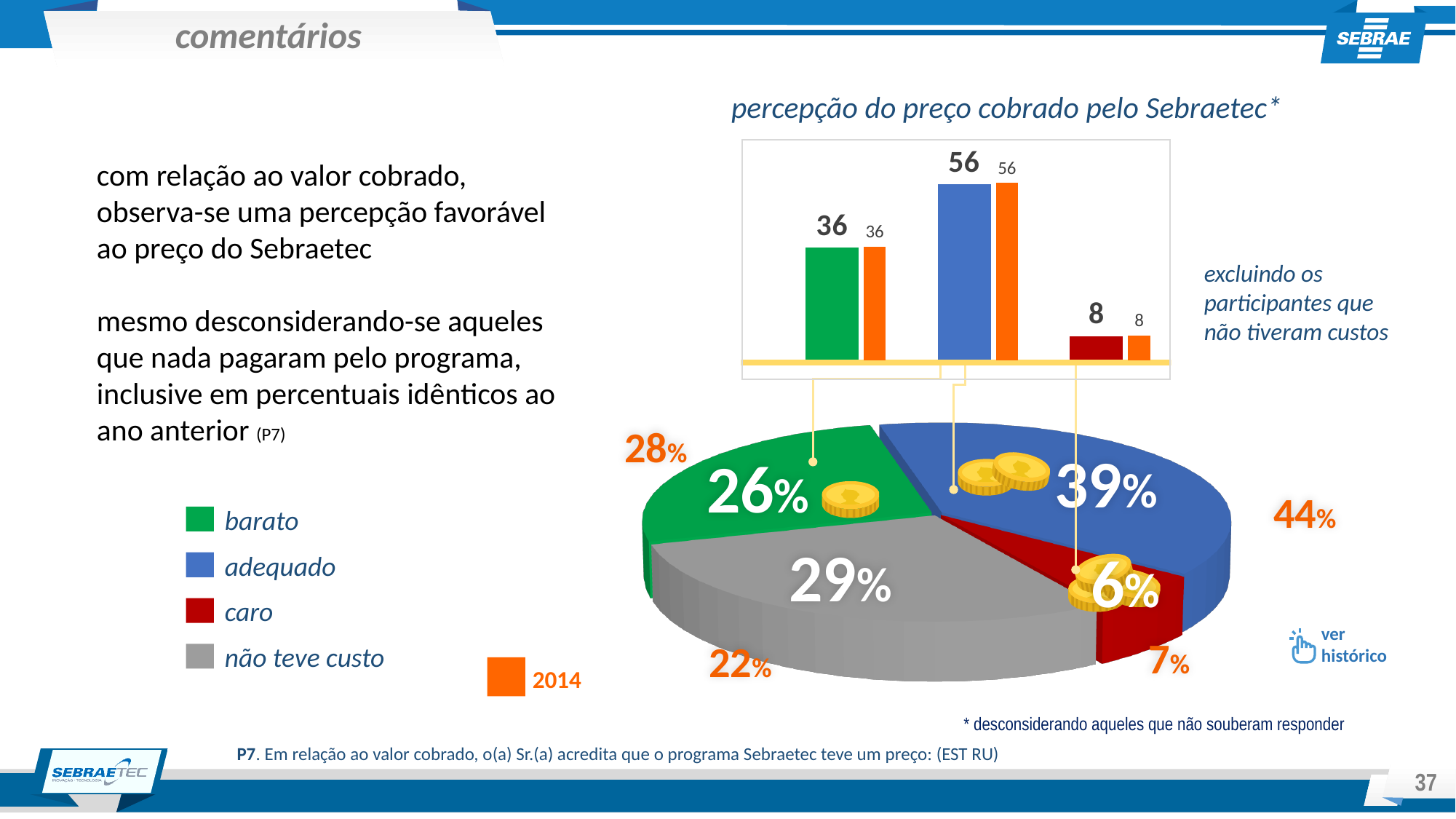
In the bar chart, what is the value for 'adequado' in the current year (blue bar)? 56 In the bar chart, what is the value for 'caro' in the current year? 8 In the pie chart, is the 'barato' slice larger or smaller than the 'não teve custo' slice? smaller In the bar chart, which category has the highest value? adequado In the pie chart, which slice is the smallest? caro In the pie chart, what share does 'não teve custo' have? 29% In the bar chart, which category has the lowest value? caro What type of chart is the lower chart on the slide? pie chart In the bar chart, what is the difference between the 'adequado' and 'barato' values for the current year? 20 In the bar chart, what is the value for 'barato' in 2014 (orange bar)? 36 In the pie chart, what was the 2014 share for 'adequado' (orange label)? 44% In the pie chart, what share does 'adequado' have? 39%